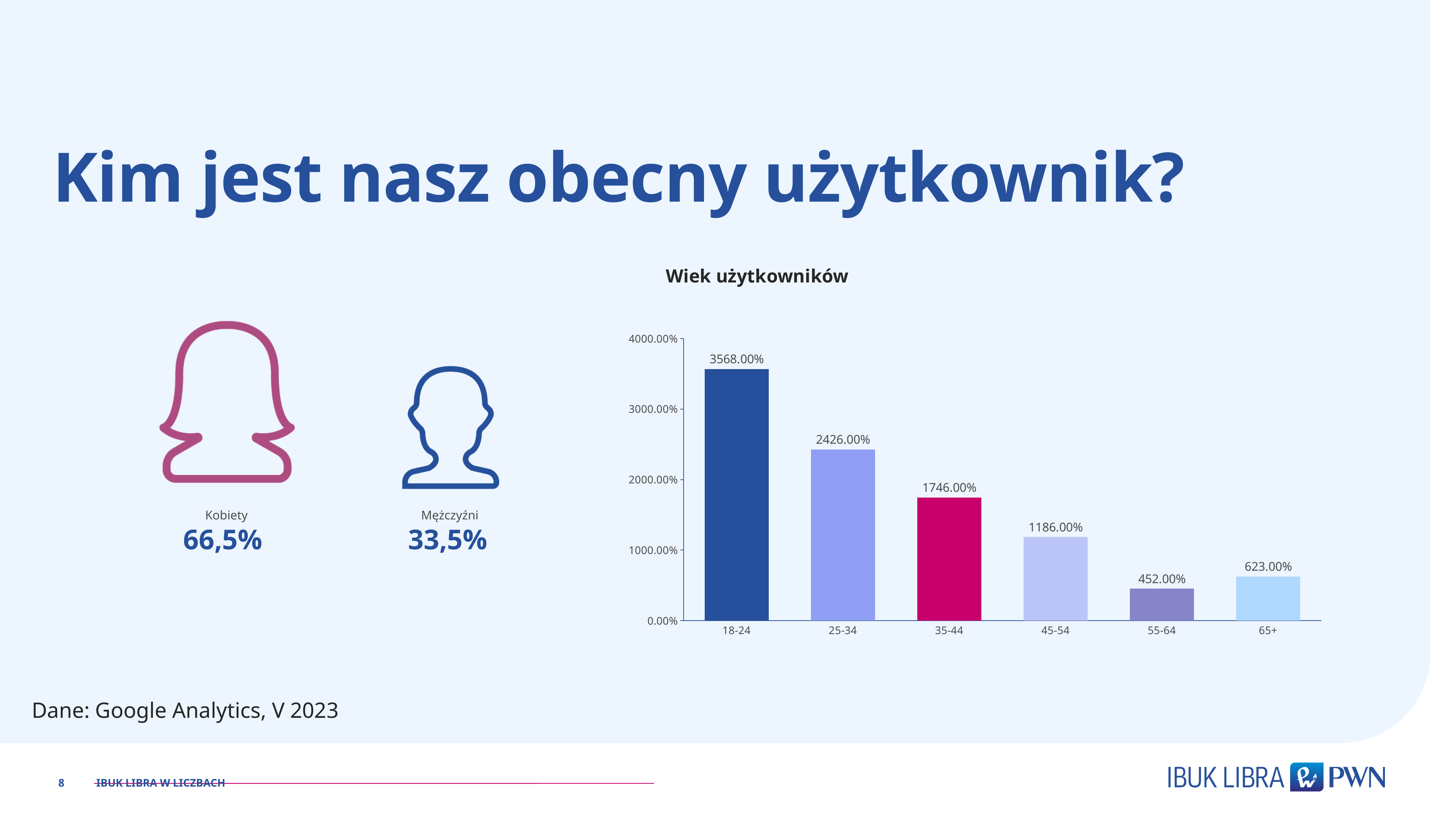
What is the value for the 18-24 age group in the Wiek użytkowników chart? 3568.00% What is the title of the chart on the slide? Wiek użytkowników What is the value for the 65+ age group in the Wiek użytkowników chart? 623.00% What is the value for the 45-54 age group in the Wiek użytkowników chart? 1186.00% How many age groups are shown in the Wiek użytkowników chart? 6 Is the value for 25-34 in the Wiek użytkowników chart greater or less than 2000.00%? greater What is the difference between the values for 18-24 and 25-34 in the Wiek użytkowników chart? 1142.00% Which has the larger value in the Wiek użytkowników chart, 35-44 or 45-54? 35-44 What kind of chart is Wiek użytkowników? bar chart What is the difference between the values for 65+ and 55-64 in the Wiek użytkowników chart? 171.00% Which age group has the highest value in the Wiek użytkowników chart? 18-24 Which age group has the lowest value in the Wiek użytkowników chart? 55-64